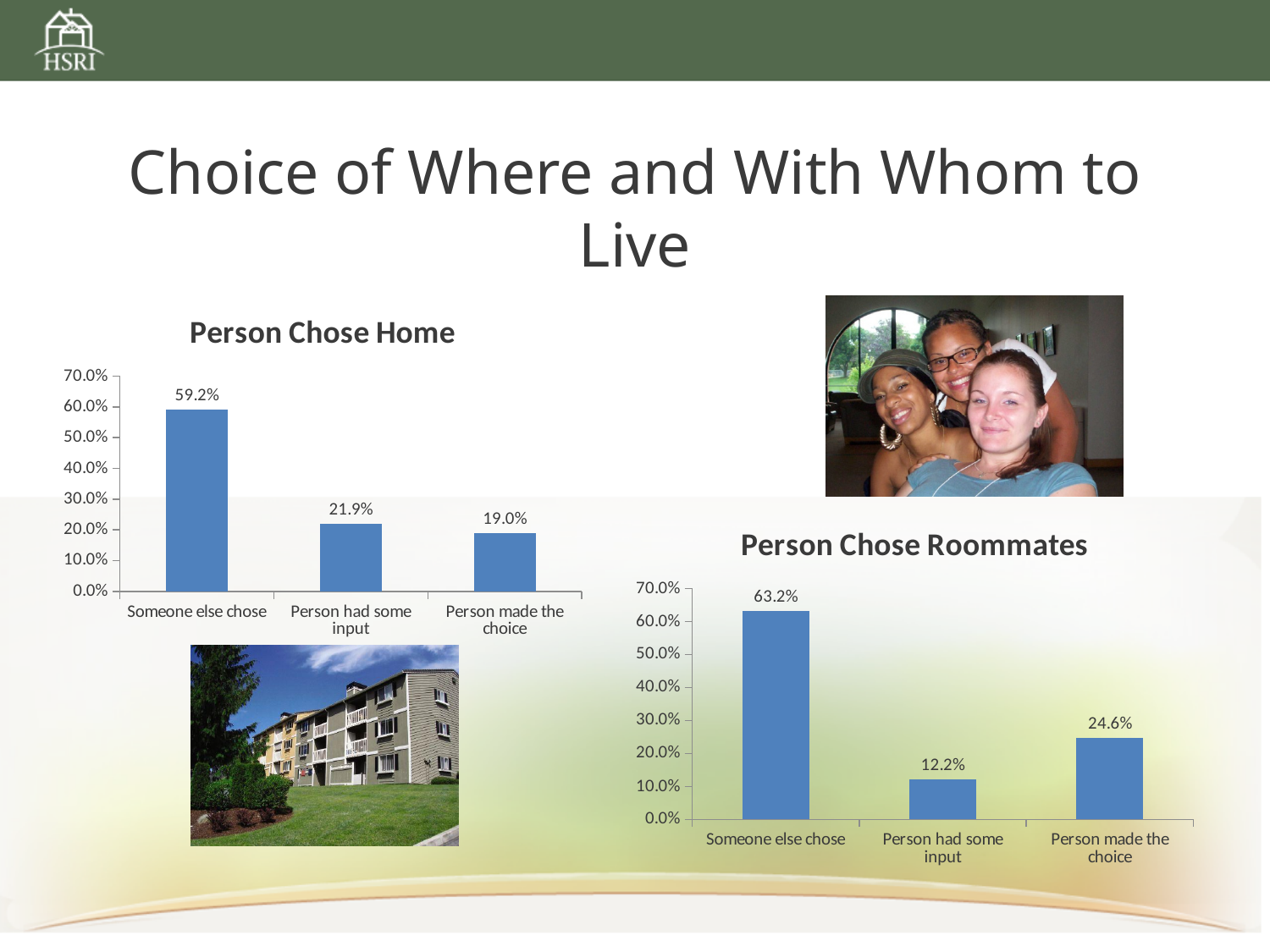
In the 'Person Chose Roommates' chart, what is the value for 'Person had some input'? 12.2% In the 'Person Chose Roommates' chart, which category has the lowest value? Person had some input In the 'Person Chose Home' chart, which category has the highest value? Someone else chose In the 'Person Chose Home' chart, what is the difference between 'Person had some input' and 'Person made the choice'? 2.9% In the 'Person Chose Home' chart, what is the value for 'Someone else chose'? 59.2% How many categories are shown in the 'Person Chose Roommates' chart? 3 What type of chart is the 'Person Chose Home' chart? Bar chart In the 'Person Chose Roommates' chart, what is the difference between 'Someone else chose' and 'Person made the choice'? 38.6% In the 'Person Chose Home' chart, is the value for 'Someone else chose' greater or less than 50.0%? greater In the 'Person Chose Roommates' chart, what is the value for 'Person made the choice'? 24.6% In the 'Person Chose Roommates' chart, which is larger: 'Person had some input' or 'Person made the choice'? Person made the choice In the 'Person Chose Home' chart, what is the value for 'Person made the choice'? 19.0%